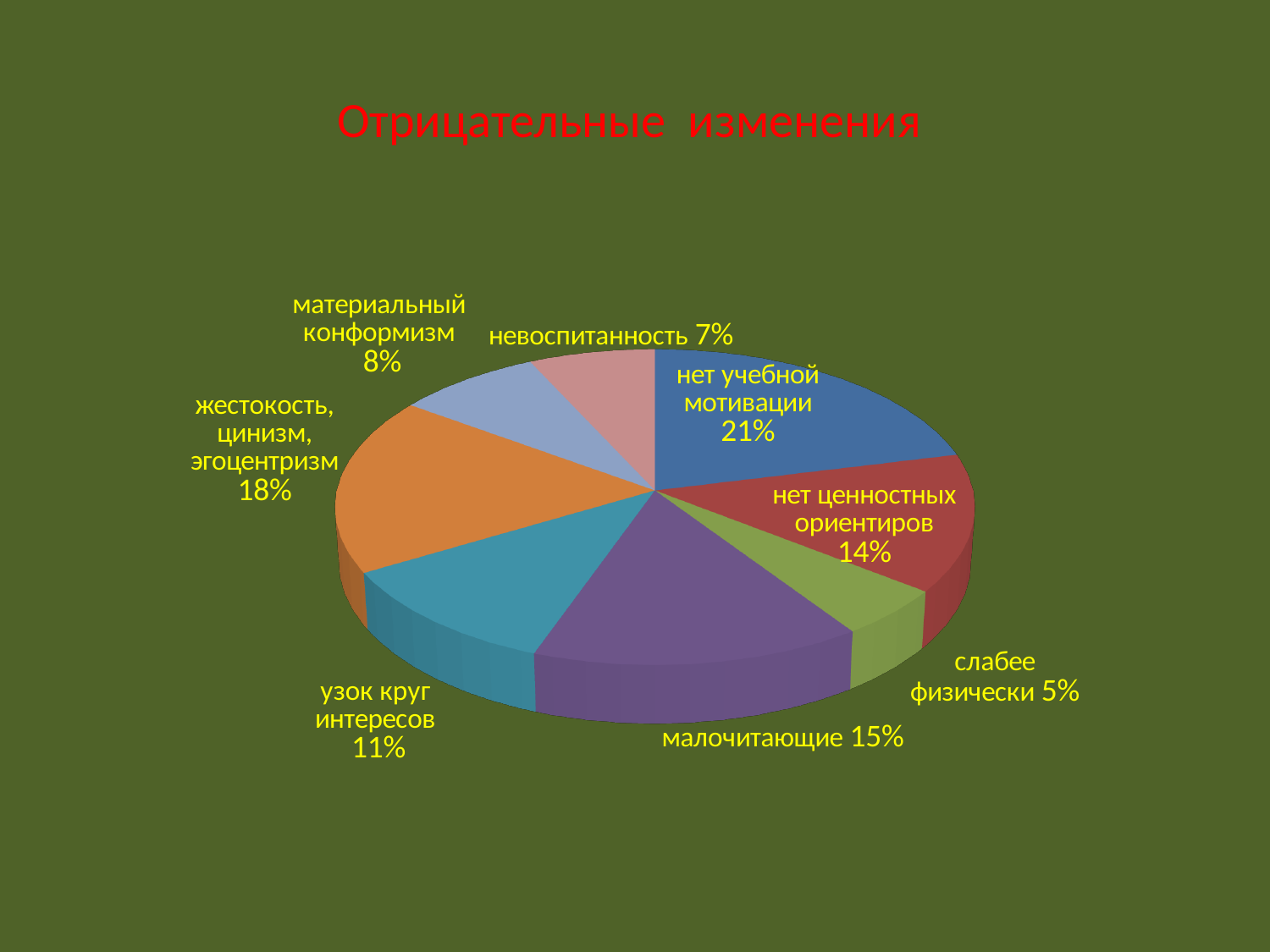
What percentage is shown for "малочитающие"? 15% Which is larger: the share for "нет ценностных ориентиров" or the share for "материальный конформизм"? нет ценностных ориентиров Which category has the smallest share of the pie? слабее физически What percentage is shown for "слабее физически"? 5% What type of chart is shown on the slide? pie chart Which category has the largest share of the pie? нет учебной мотивации What share of the pie is labelled "нет учебной мотивации"? 21% What percentage is shown for "невоспитанность"? 7% How many slices does the pie chart have? 8 What is the combined percentage of "материальный конформизм" and "невоспитанность"? 15% What is the difference in percentage points between "жестокость, цинизм, эгоцентризм" and "узок круг интересов"? 7 What is the title of the chart? Отрицательные изменения